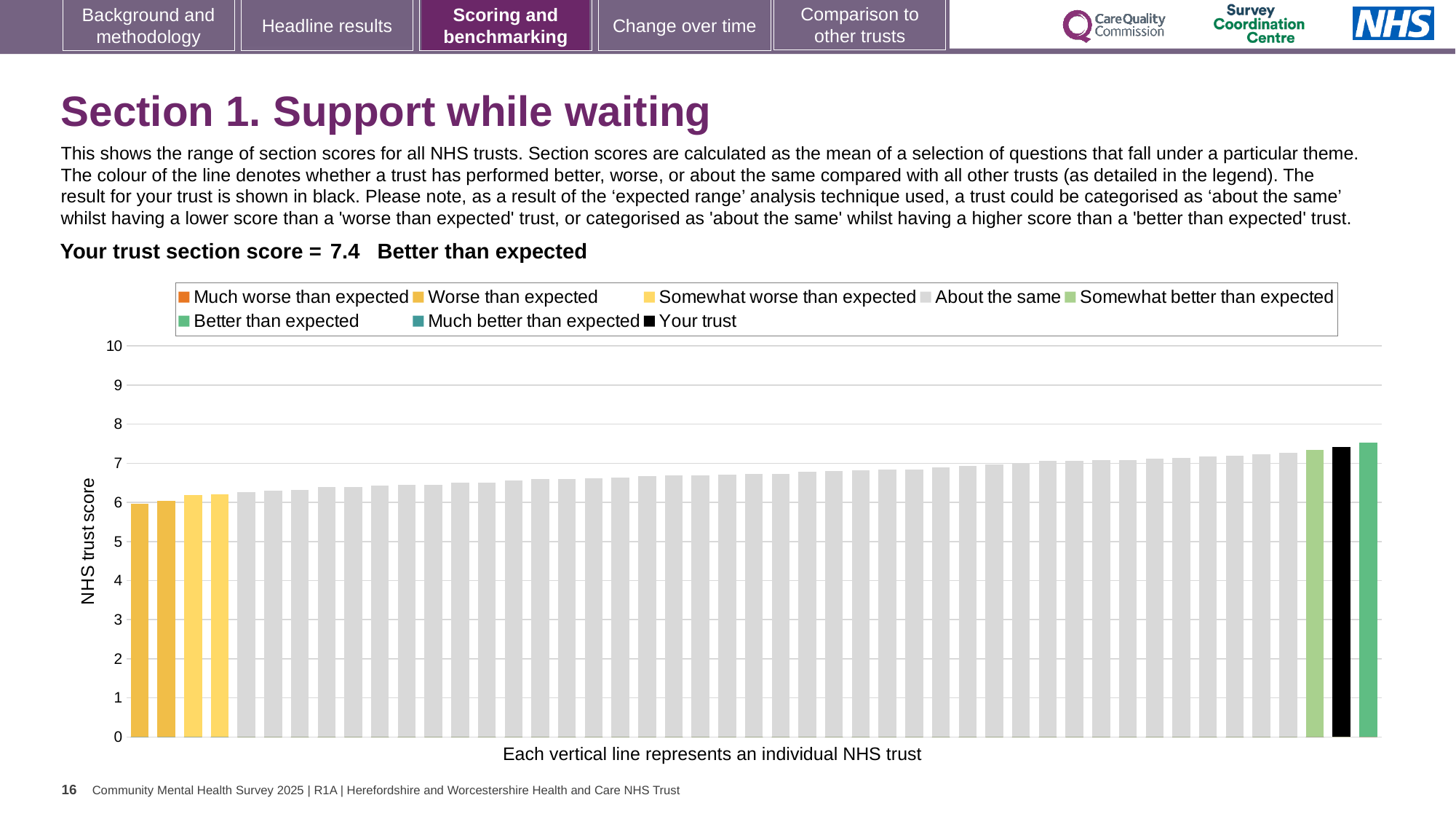
How many bars are coloured as 'Worse than expected' (the darker yellow)? 2 Is the value of the black 'Your trust' bar greater or less than 7? greater Is the value of the tallest bar greater or less than 8? less What colour is the bar representing your trust? black What is the title of the vertical axis? NHS trust score How many entries does the chart legend list? 8 Which category is your trust's section score placed in? Better than expected Do the bar values rise or fall from left to right across the chart? rise Which is taller: the black 'Your trust' bar or the leftmost bar? the black 'Your trust' bar What is the section score for your trust shown on the slide? 7.4 What kind of chart is shown on the slide? bar chart Is the value of the leftmost bar greater or less than 7? less